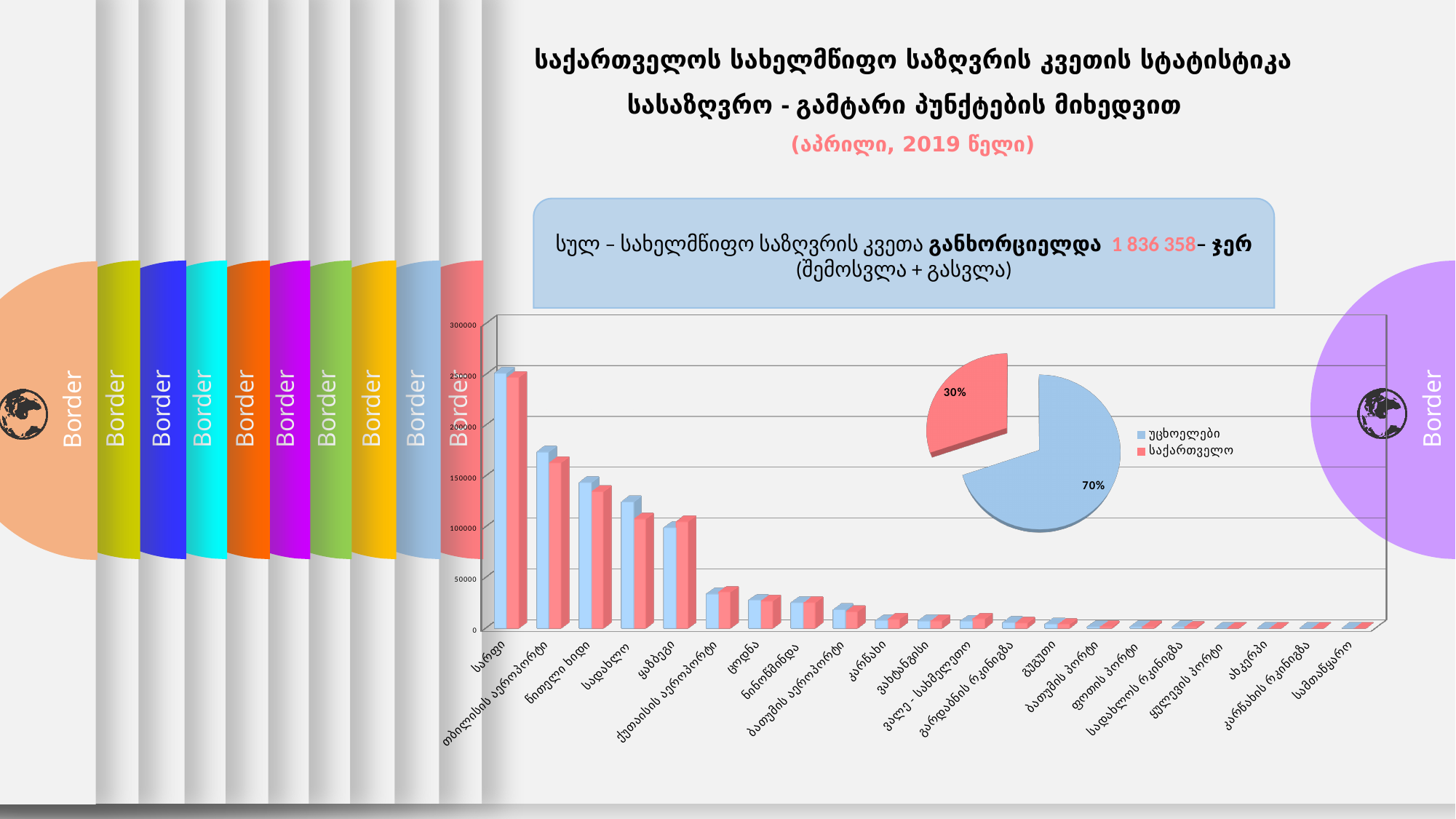
In the pie chart, what share is labelled for the უცხოელები slice? 70% In the bar chart, which category has the highest bars? სარფი In the pie chart, what share is labelled for the საქართველო slice? 30% What kind of chart is the chart on the right side of the slide, with the 30% and 70% labels? pie chart In the pie chart, by how many percentage points does the უცხოელები slice exceed the საქართველო slice? 40 In the bar chart, do the values generally rise or fall moving from left to right along the category axis? fall What kind of chart is the chart on the left side of the slide, with the category axis listing border crossing points? bar chart In the pie chart, which slice is larger, უცხოელები or საქართველო? უცხოელები How many series does the legend list? 2